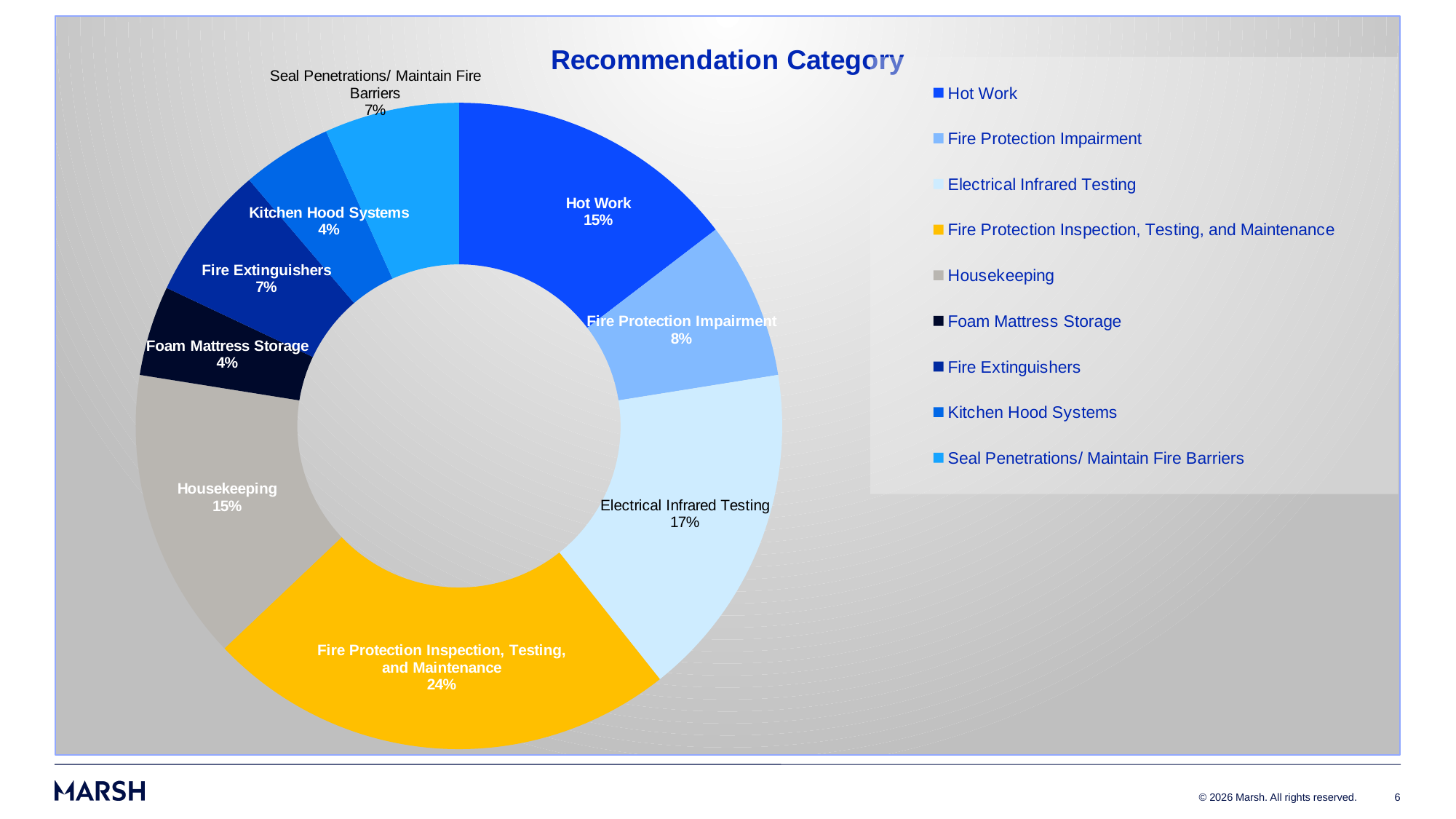
What is the value for Foam Mattress Storage? 4% What is the difference in percentage points between Electrical Infrared Testing and Housekeeping? 2 What kind of chart is shown on the slide? Pie chart (doughnut) What share of the chart does Fire Protection Inspection, Testing, and Maintenance represent? 24% How many categories are shown in the chart? 9 What percentage is shown for Electrical Infrared Testing? 17% What percentage is shown for Seal Penetrations/ Maintain Fire Barriers? 7% Which category has the largest share: Hot Work or Fire Protection Impairment? Hot Work Which category has the largest share of the chart? Fire Protection Inspection, Testing, and Maintenance What is the difference in percentage points between Fire Protection Inspection, Testing, and Maintenance and Fire Extinguishers? 17 What is the title of the chart? Recommendation Category Which category is shown in yellow? Fire Protection Inspection, Testing, and Maintenance